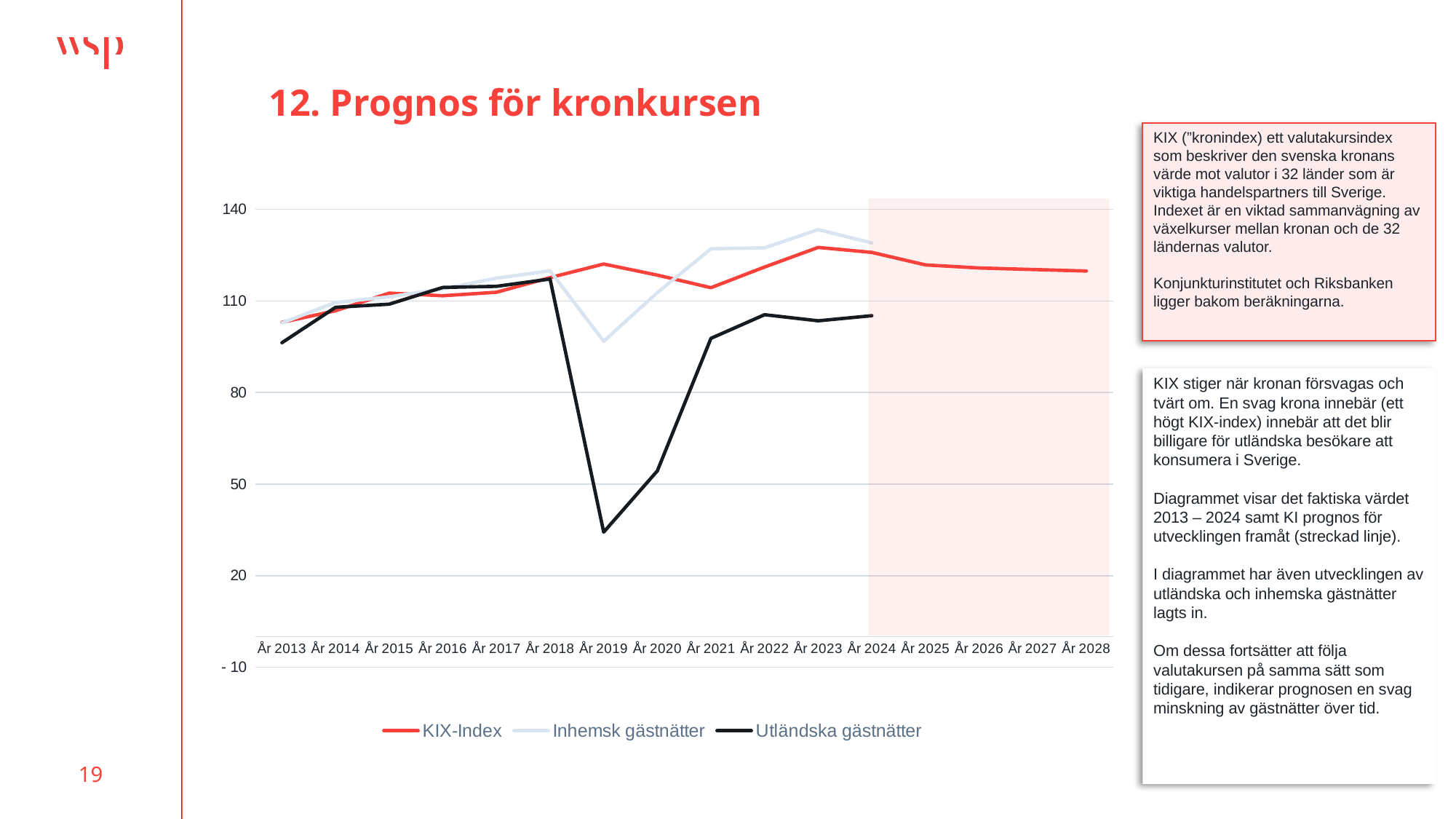
In År 2019, which is higher: KIX-Index or Utländska gästnätter? KIX-Index What is the title of the slide's chart section? 12. Prognos för kronkursen Is the value for Inhemsk gästnätter in År 2019 greater or less than 110? less What kind of chart is shown on the slide? Line chart Which series is drawn in red in the legend? KIX-Index How many series does the legend list? 3 How many years are shown on the x axis? 16 Does Utländska gästnätter rise or fall from År 2019 to År 2022? Rise Is the value for KIX-Index in År 2023 greater or less than 110? greater Is the value for Utländska gästnätter in År 2019 greater or less than 50? less In År 2023, which is higher: Inhemsk gästnätter or Utländska gästnätter? Inhemsk gästnätter In which year is Utländska gästnätter at its lowest? År 2019